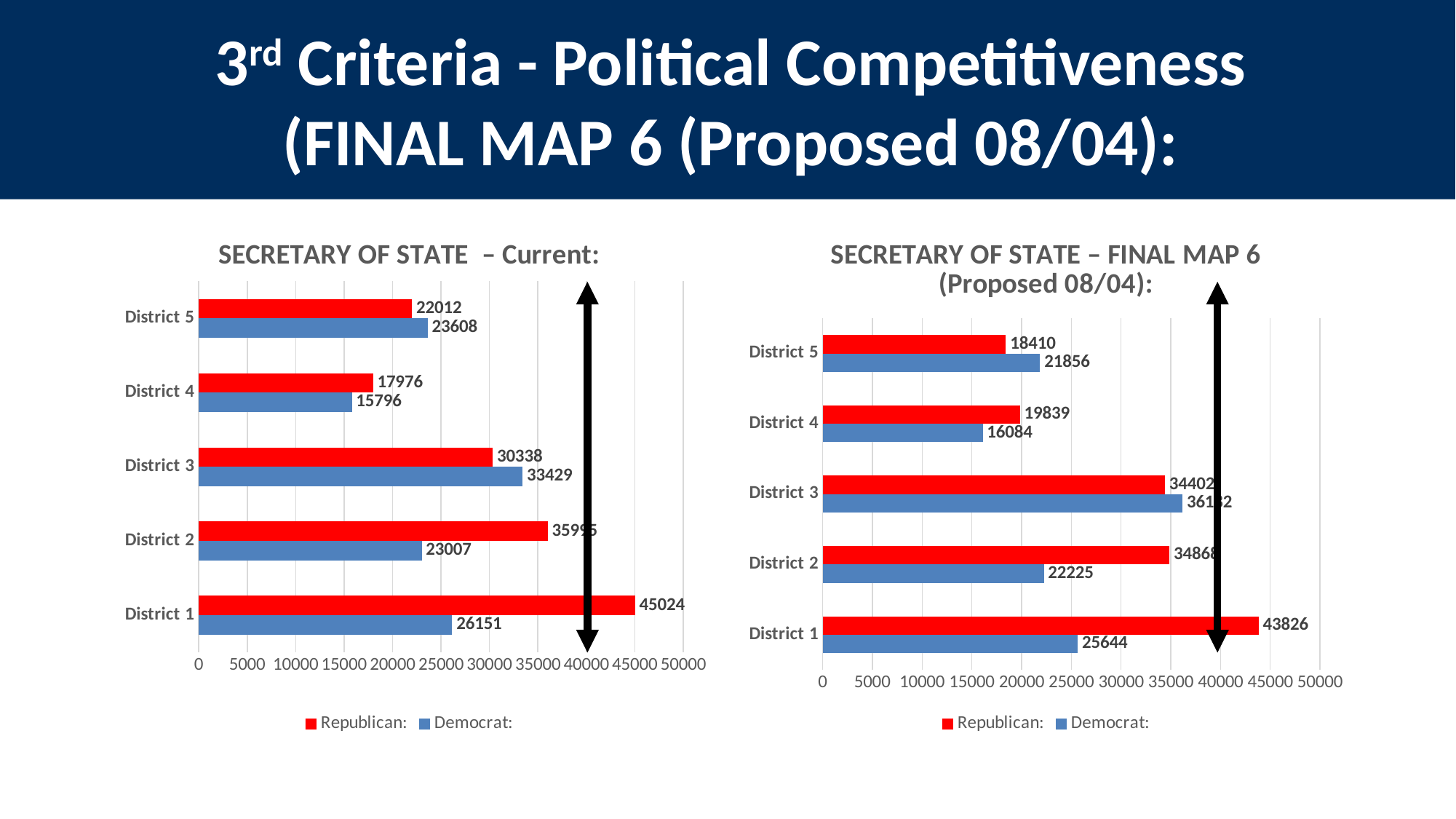
How many districts are shown in the 'SECRETARY OF STATE – Current' chart? 5 In the 'SECRETARY OF STATE – FINAL MAP 6' chart, what is the Democrat value for District 5? 21856 In the 'SECRETARY OF STATE – Current' chart, what is the Republican value for District 1? 45024 What type of chart is the 'SECRETARY OF STATE – FINAL MAP 6' chart? bar chart In the 'SECRETARY OF STATE – Current' chart, which is larger for District 4, the Republican or the Democrat value? Republican In the 'SECRETARY OF STATE – FINAL MAP 6' chart, is the Republican value for District 1 greater or less than 40000? greater In the 'SECRETARY OF STATE – FINAL MAP 6' chart, which district has the lowest Democrat value? District 4 In the 'SECRETARY OF STATE – Current' chart, which district has the highest Republican value? District 1 In the 'SECRETARY OF STATE – Current' chart, what is the difference between the Republican and Democrat values for District 1? 18873 In the 'SECRETARY OF STATE – FINAL MAP 6' chart, what is the Republican value for District 4? 19839 In the 'SECRETARY OF STATE – FINAL MAP 6' chart, what is the difference between the Democrat and Republican values for District 5? 3446 In the 'SECRETARY OF STATE – Current' chart, what is the Democrat value for District 3? 33429